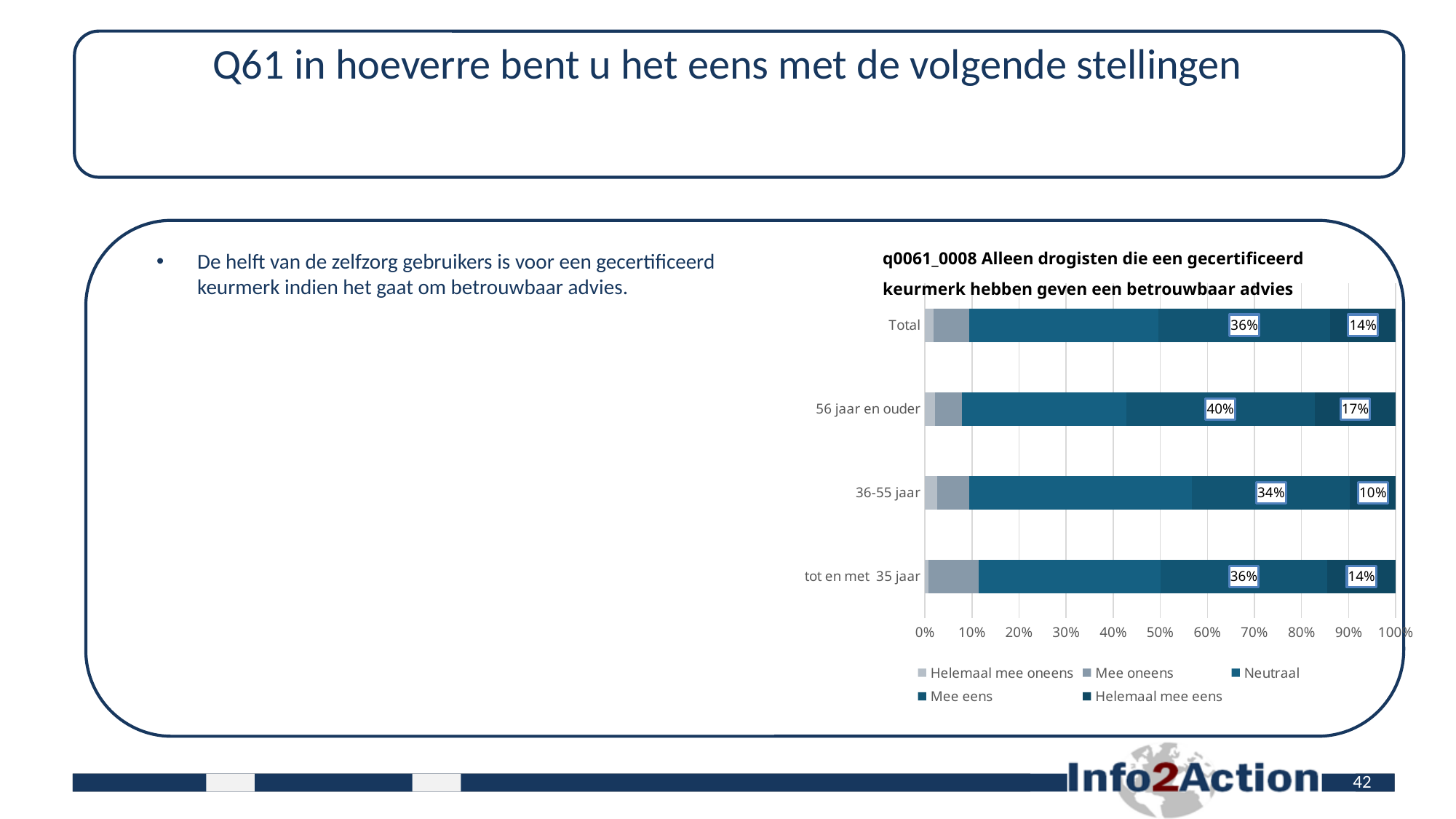
What is the 'Mee eens' value for '56 jaar en ouder'? 40% What is the 'Helemaal mee eens' value for 'tot en met 35 jaar'? 14% What is the 'Mee eens' value for 'Total'? 36% How many series does the legend list? 5 What is the 'Helemaal mee eens' value for '36-55 jaar'? 10% Is the 'Helemaal mee oneens' value for 'Total' greater or less than 10%? less Which category has the highest 'Mee eens' value? 56 jaar en ouder Which is larger: the 'Helemaal mee eens' value for '56 jaar en ouder' or for 'Total'? 56 jaar en ouder What type of chart is shown on the slide? Stacked bar chart How many categories are shown on the vertical axis of the chart? 4 What is the difference between the 'Mee eens' values for '56 jaar en ouder' and '36-55 jaar'? 6 percentage points Which category has the lowest 'Helemaal mee eens' value? 36-55 jaar